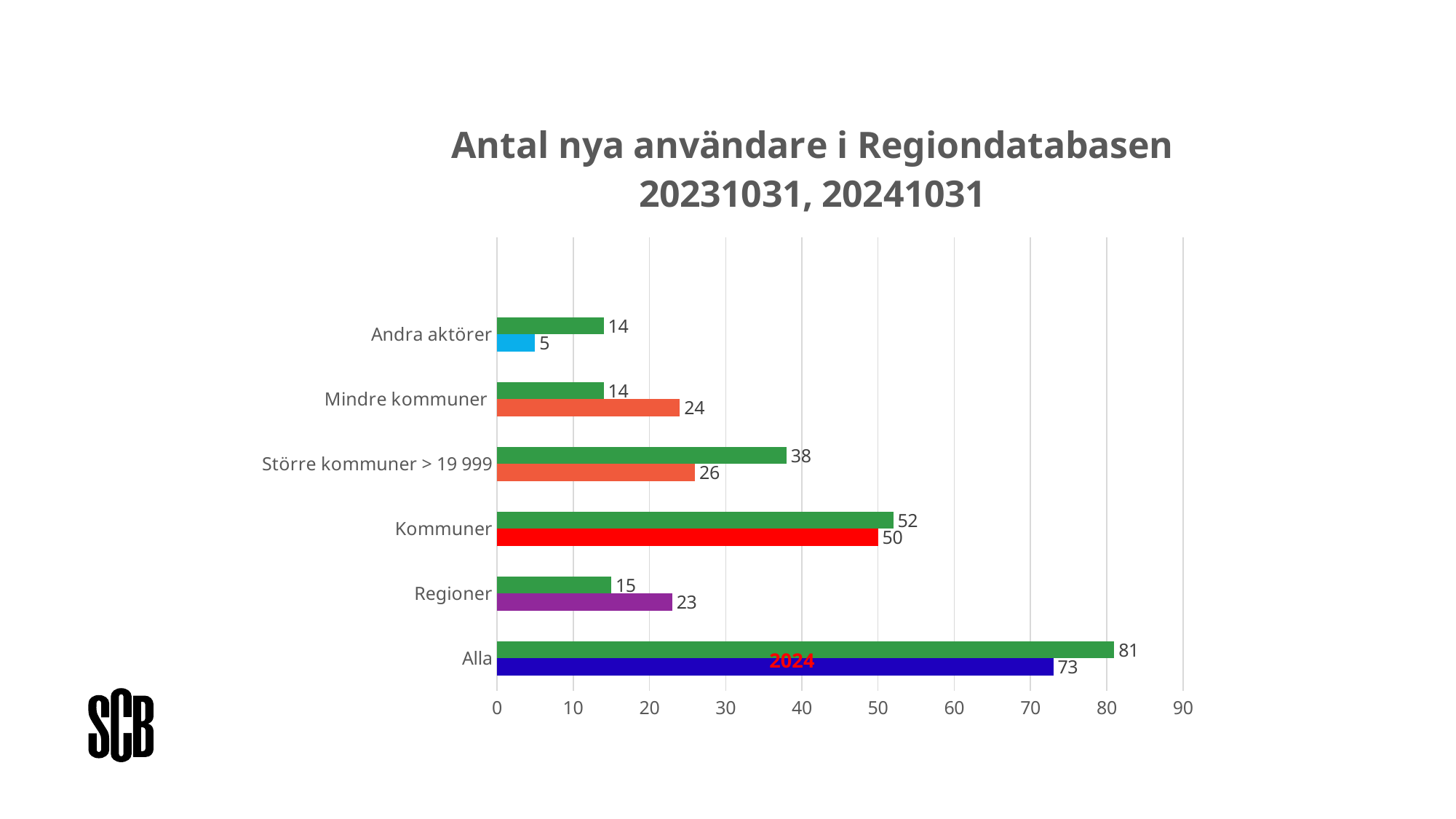
What type of chart is shown on the slide? bar chart What is the value of the lower (blue) bar for Alla? 73 What is the title of the chart? Antal nya användare i Regiondatabasen 20231031, 20241031 What is the value of the green bar for Större kommuner > 19 999? 38 What is the value of the green bar for Alla? 81 What is the difference between the two bars for Kommuner? 2 For Mindre kommuner, which is larger: the green bar or the lower (orange) bar? the lower (orange) bar How many categories are shown on the vertical axis of the chart? 6 Which category has the highest green bar value? Alla Which category has the smallest value among all bars in the chart? Andra aktörer What is the difference between the green bar and the lower bar for Alla? 8 What is the value of the lower (purple) bar for Regioner? 23